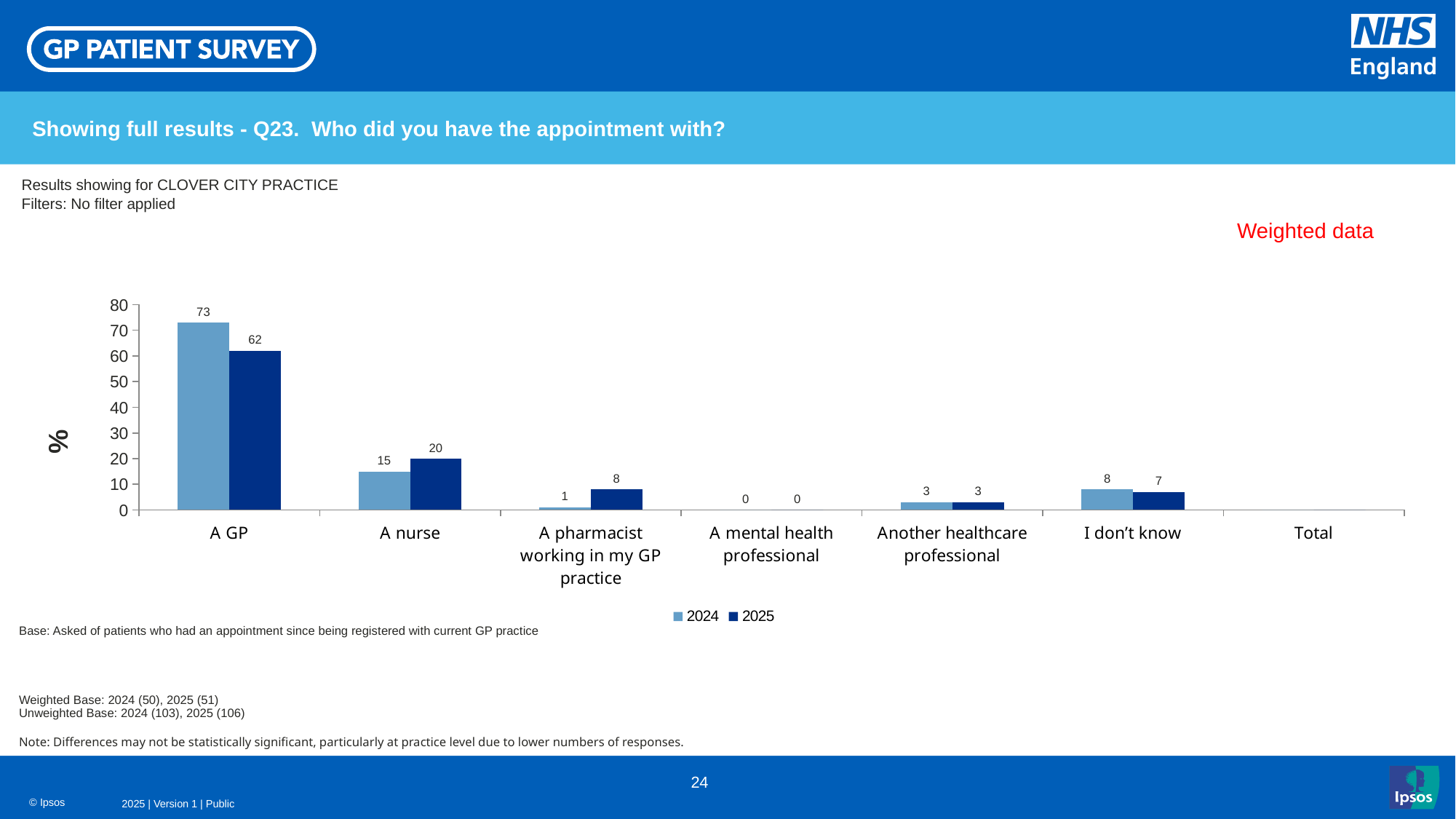
What is the 2025 value for A pharmacist working in my GP practice? 8 How many series does the legend list? 2 Which category has the lowest 2024 value? A mental health professional What is the label on the vertical axis of the chart? % What is the difference between the 2024 and 2025 values for A GP? 11 What is the 2024 value for A GP? 73 What is the 2024 value for I don't know? 8 Which category has the highest 2025 value? A GP Which is larger for A nurse, the 2024 value or the 2025 value? 2025 Is the 2025 value for A GP greater or less than 50? greater What is the 2025 value for A nurse? 20 What kind of chart is shown on the slide? Bar chart